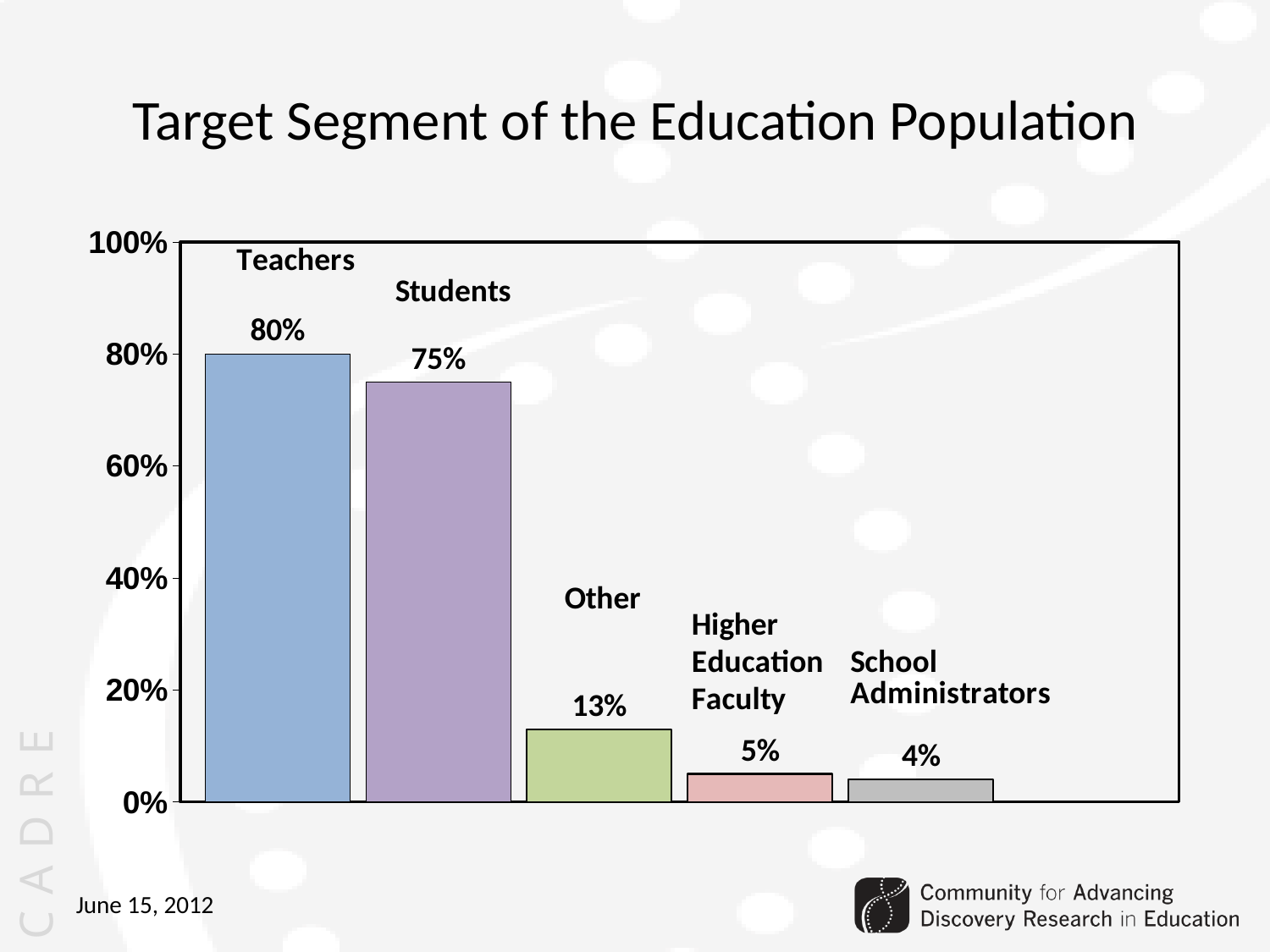
Which category has the lowest value? School Administrators What kind of chart is shown on the slide? Bar chart What is the value for Teachers? 80% What is the value for School Administrators? 4% Which is larger, the value for Other or the value for Higher Education Faculty? Other Which category has the highest value? Teachers What is the value for Higher Education Faculty? 5% What is the value for Students? 75% How many categories are shown in the chart? 5 What is the difference between the values for Other and Higher Education Faculty? 8% What is the title of the chart? Target Segment of the Education Population What is the difference between the values for Teachers and Students? 5%